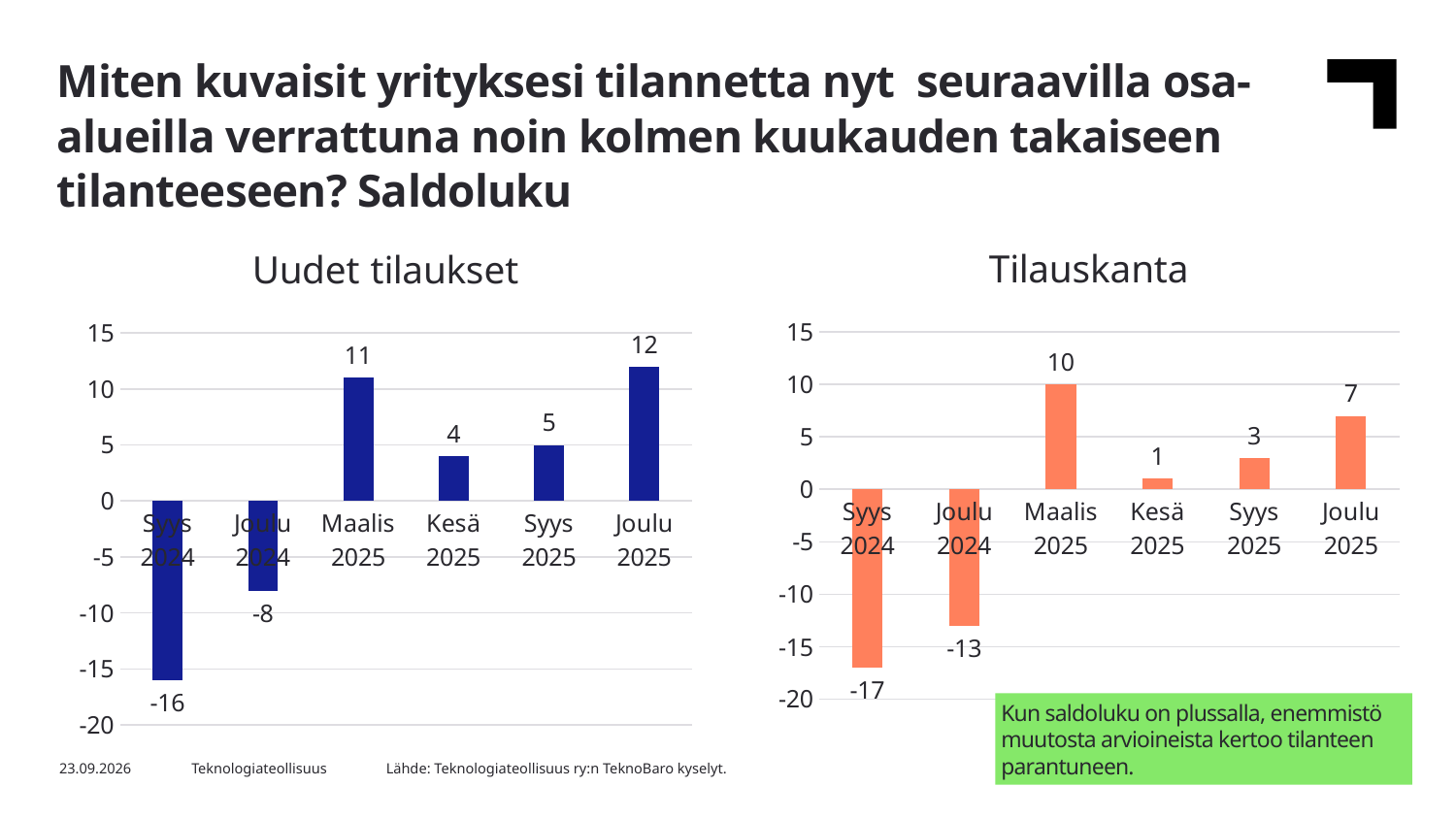
What kind of chart is the 'Uudet tilaukset' chart? Bar chart In the 'Tilauskanta' chart, what is the value for Kesä 2025? 1 In the 'Tilauskanta' chart, what is the difference between the values for Maalis 2025 and Joulu 2025? 3 In the 'Tilauskanta' chart, what is the value for Joulu 2024? -13 In the 'Tilauskanta' chart, do the values rise or fall from Kesä 2025 to Joulu 2025? Rise In the 'Tilauskanta' chart, which period has the lowest value? Syys 2024 How many periods are shown on the x axis of the 'Tilauskanta' chart? 6 In the 'Uudet tilaukset' chart, what is the value for Maalis 2025? 11 In the 'Uudet tilaukset' chart, what is the value for Syys 2024? -16 In the 'Uudet tilaukset' chart, which period has the highest value? Joulu 2025 What is the title of the chart on the right side of the slide? Tilauskanta In the 'Uudet tilaukset' chart, which is larger, the value for Kesä 2025 or Syys 2025? Syys 2025